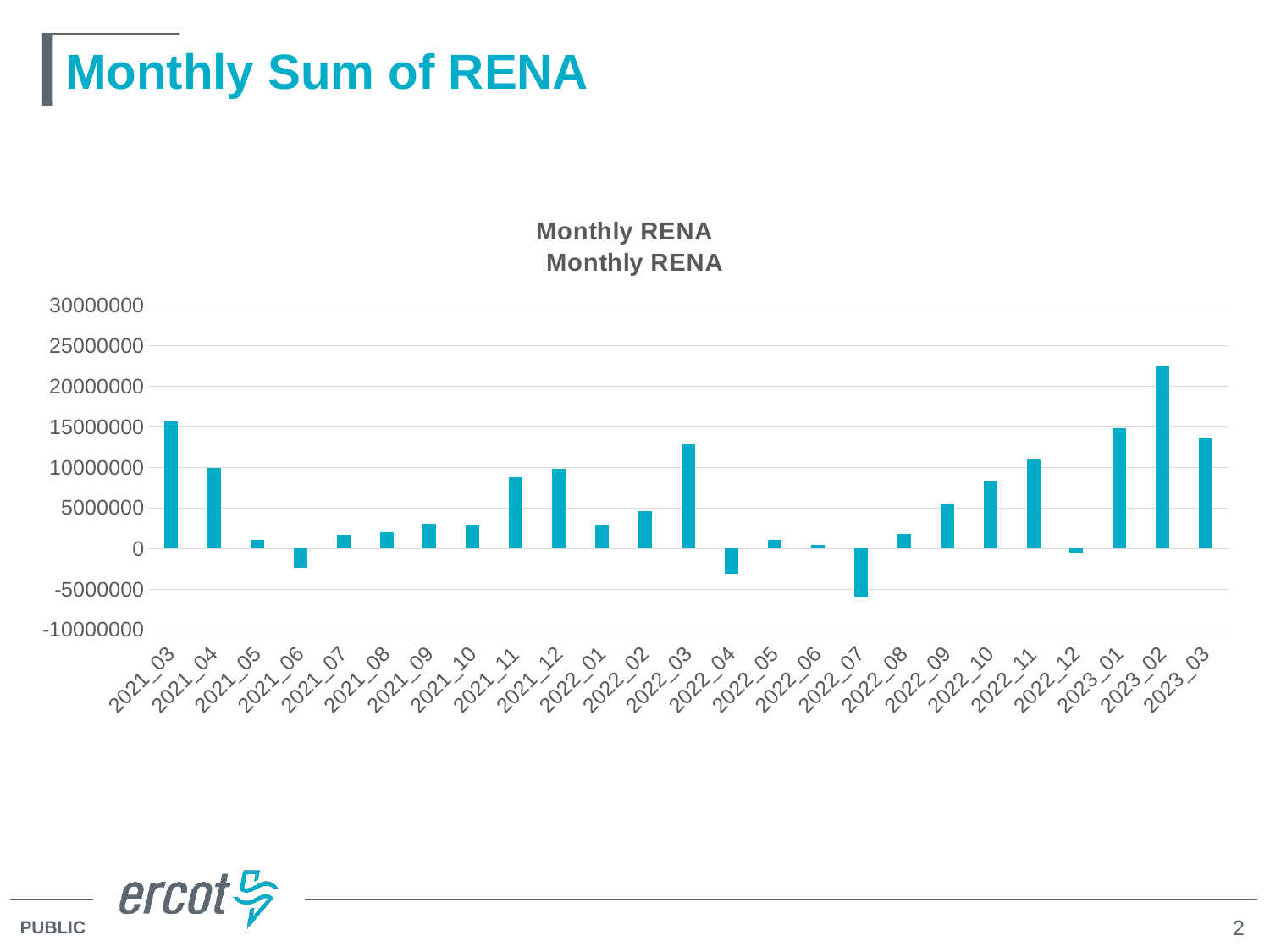
What kind of chart is shown on the slide? bar chart Which month has the lowest monthly RENA value? 2022_07 Which is larger, the value for 2022_03 or the value for 2022_02? 2022_03 Is the value for 2023_01 greater or less than 10000000? greater Is the value for 2022_07 greater or less than -5000000? less Is the value for 2022_03 greater or less than 10000000? greater What is the title of the chart? Monthly RENA Which month has the highest monthly RENA value? 2023_02 How many months are plotted on the x axis? 25 Do the values rise or fall from 2022_07 to 2022_11? rise Which is larger, the value for 2023_02 or the value for 2021_03? 2023_02